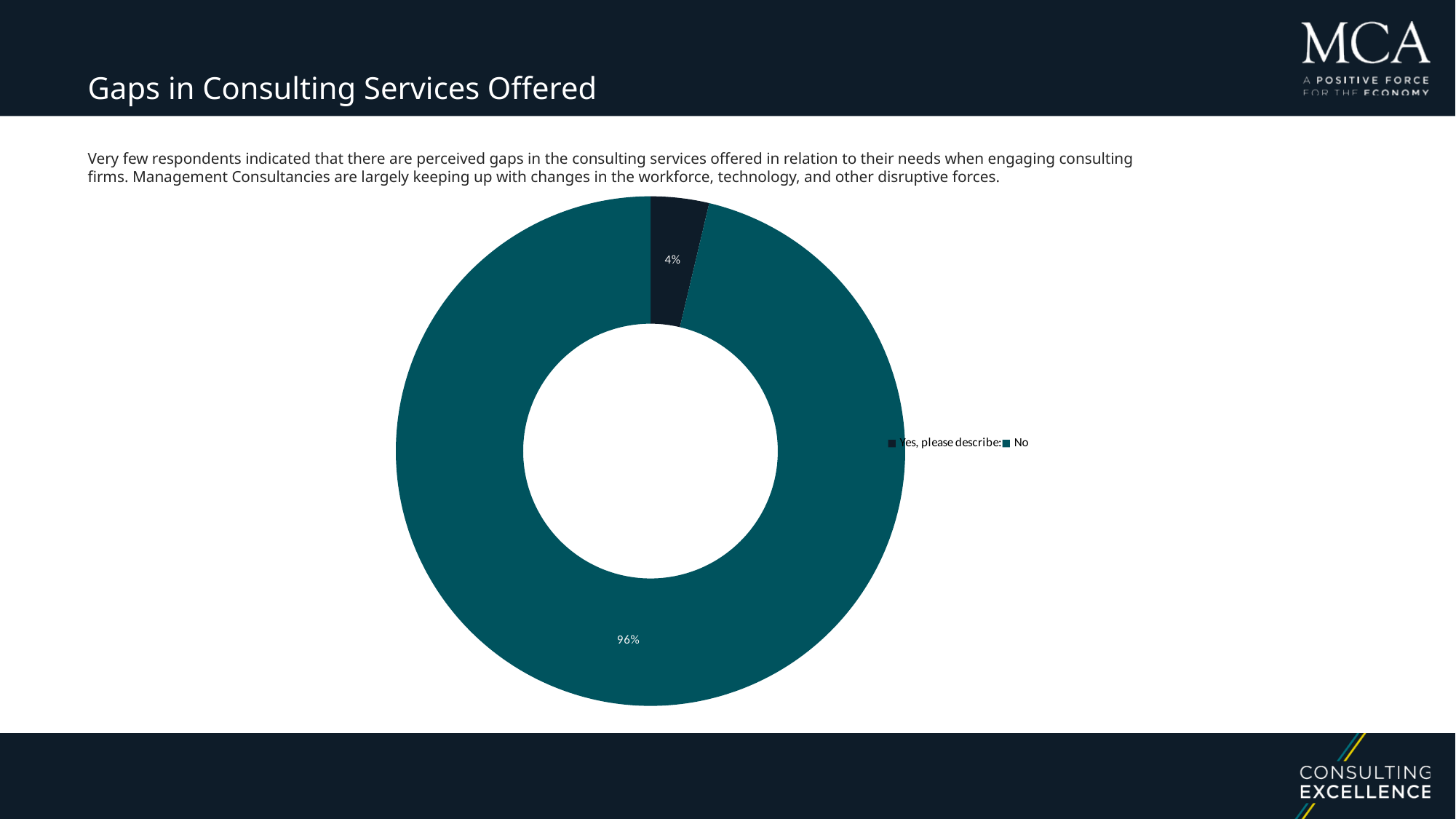
Which category has the smallest share of the chart? Yes, please describe: What kind of chart is shown on the slide? Doughnut (pie) chart Which category has the largest share of the chart? No What is the difference in percentage points between the "No" and "Yes, please describe:" shares? 92 How many entries does the legend list? 2 Which legend entry is shown with the dark navy colour? Yes, please describe: What share of the chart does the "No" slice represent? 96% Which is larger, the share for "No" or the share for "Yes, please describe:"? No What is the title of the slide containing the chart? Gaps in Consulting Services Offered What percentage of respondents answered "Yes, please describe:"? 4% How many categories are shown in the chart? 2 What percentage of respondents answered "No"? 96%